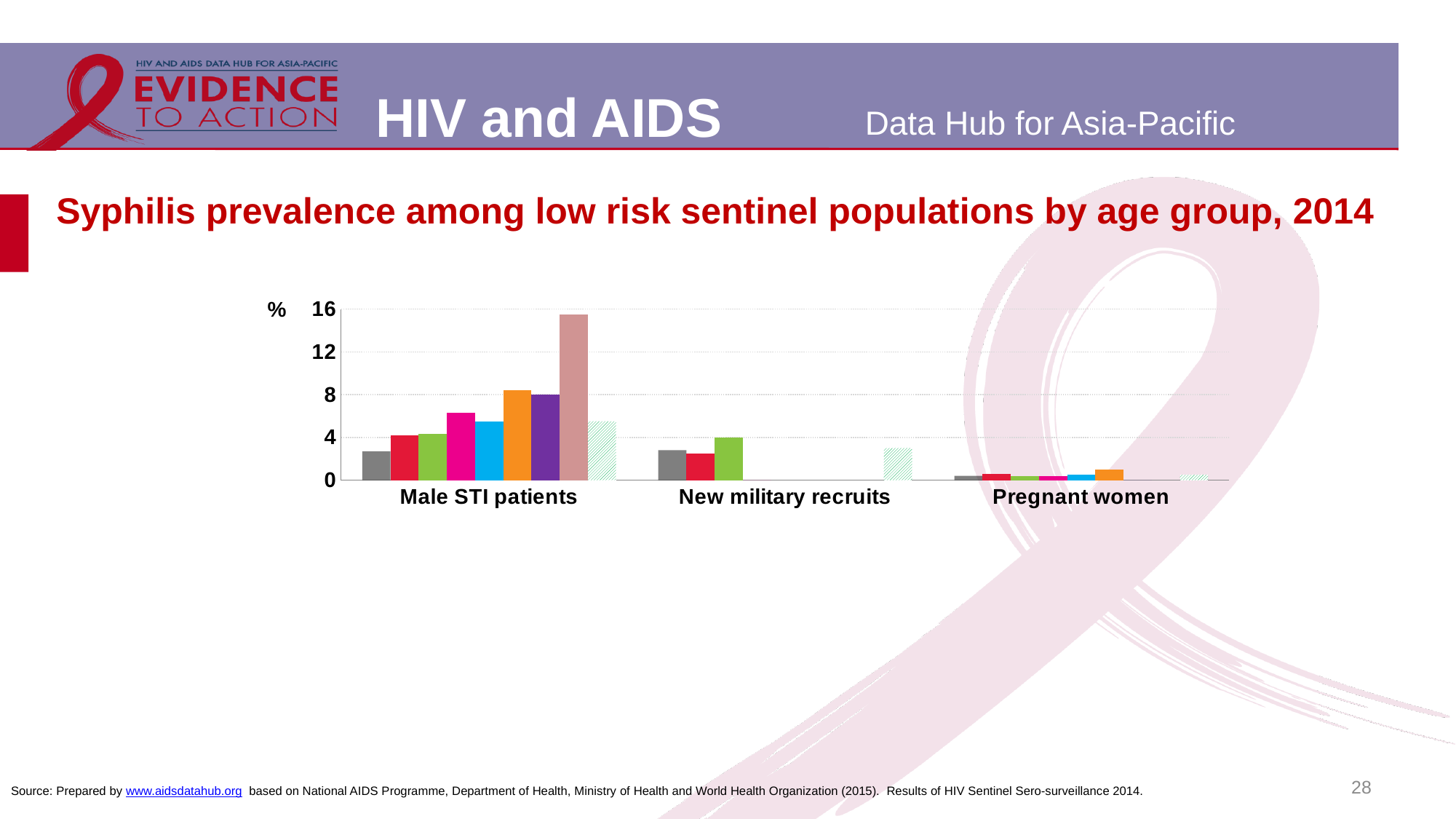
Which is larger: the tallest bar for Male STI patients or the tallest bar for New military recruits? Male STI patients What is the title of the chart? Syphilis prevalence among low risk sentinel populations by age group, 2014 Are all the bars for Pregnant women greater or less than 4? less What is the highest value shown on the y axis? 16 Is the pink bar for Male STI patients greater or less than 4? greater What kind of chart is shown on the slide? bar chart Which category contains the tallest bar in the chart? Male STI patients Which category has the lowest bars overall? Pregnant women Is the grey bar for New military recruits greater or less than 4? less What unit is shown on the y axis of the chart? % How many sentinel population categories are shown on the x axis? 3